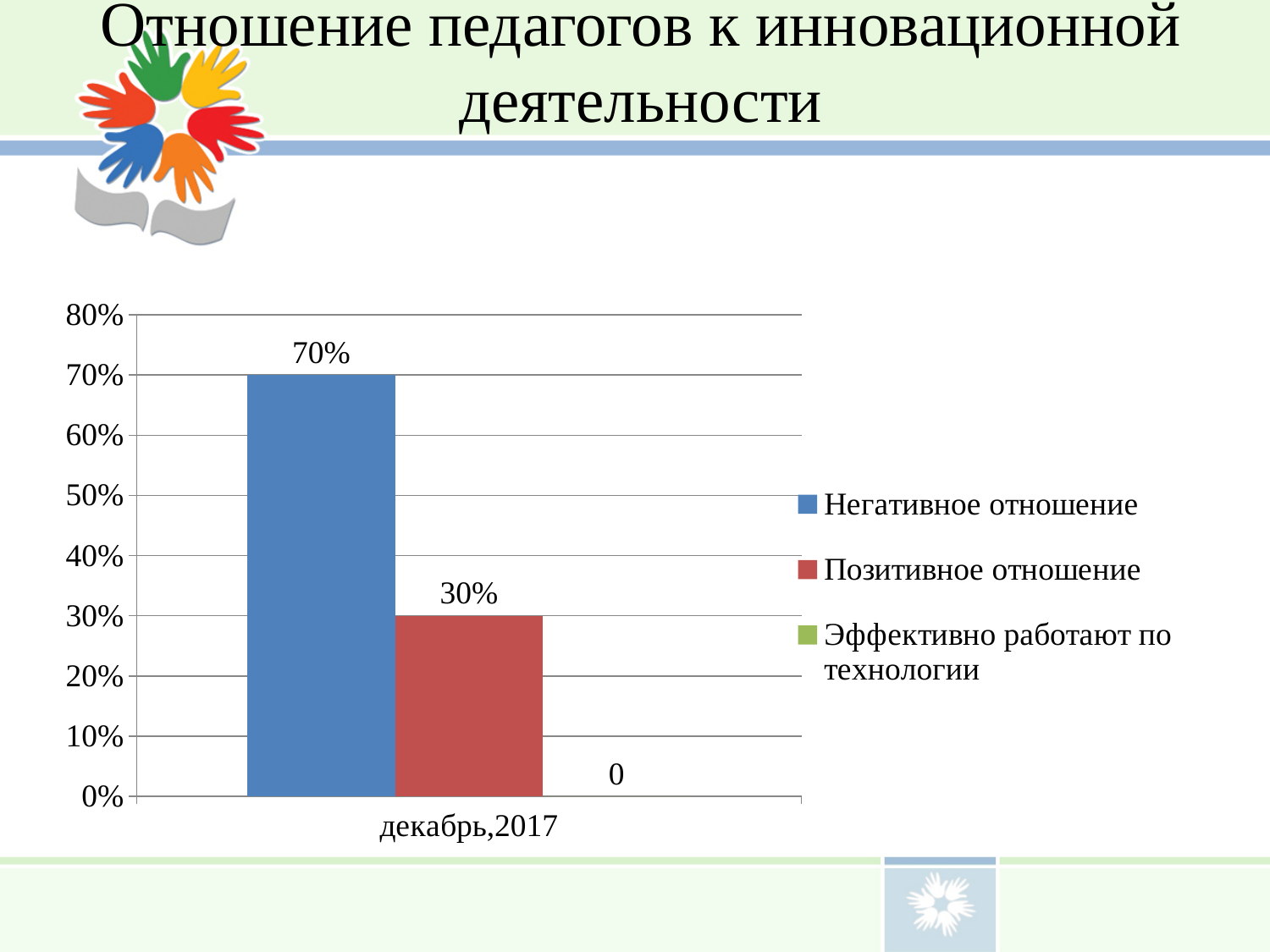
What kind of chart is shown on the slide? bar chart What is the value for Эффективно работают по технологии in декабрь,2017? 0 Which series has the highest value in декабрь,2017? Негативное отношение What is the difference between Негативное отношение and Позитивное отношение in декабрь,2017? 40% Which is larger in декабрь,2017: Негативное отношение or Позитивное отношение? Негативное отношение What is the category label on the x axis? декабрь,2017 How many categories are shown on the x axis? 1 What is the value for Негативное отношение in декабрь,2017? 70% Which series has the lowest value in декабрь,2017? Эффективно работают по технологии What is the value for Позитивное отношение in декабрь,2017? 30% Is the value for Негативное отношение greater or less than 60%? greater How many series does the legend list? 3